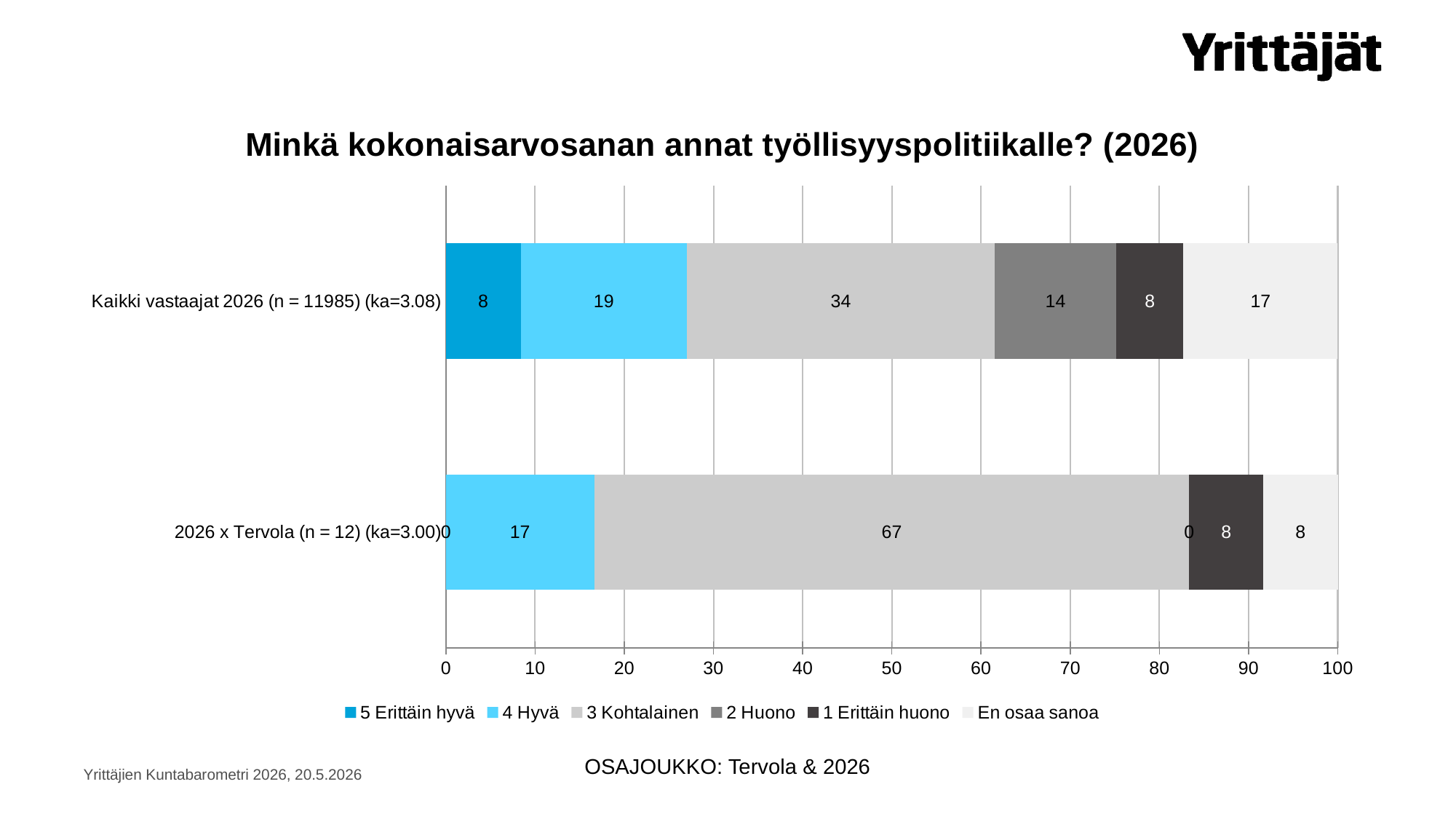
What is the difference between the "3 Kohtalainen" values for "2026 x Tervola (n = 12) (ka=3.00)" and "Kaikki vastaajat 2026 (n = 11985) (ka=3.08)"? 33 What is the value for "4 Hyvä" in the "2026 x Tervola (n = 12) (ka=3.00)" bar? 17 What is the value for "3 Kohtalainen" in the "Kaikki vastaajat 2026 (n = 11985) (ka=3.08)" bar? 34 What is the title of the chart? Minkä kokonaisarvosanan annat työllisyyspolitiikalle? (2026) What is the total of the "Kaikki vastaajat 2026 (n = 11985) (ka=3.08)" stacked bar? 100 How many bars (categories) are shown in the chart? 2 Which series has the highest value in the "2026 x Tervola (n = 12) (ka=3.00)" bar? 3 Kohtalainen How many series does the legend list? 6 Which bar has the larger value for "En osaa sanoa": "Kaikki vastaajat 2026 (n = 11985) (ka=3.08)" or "2026 x Tervola (n = 12) (ka=3.00)"? Kaikki vastaajat 2026 (n = 11985) (ka=3.08) What is the value for "5 Erittäin hyvä" in the "2026 x Tervola (n = 12) (ka=3.00)" bar? 0 What is the value for "2 Huono" in the "Kaikki vastaajat 2026 (n = 11985) (ka=3.08)" bar? 14 What kind of chart is shown on the slide? Stacked bar chart